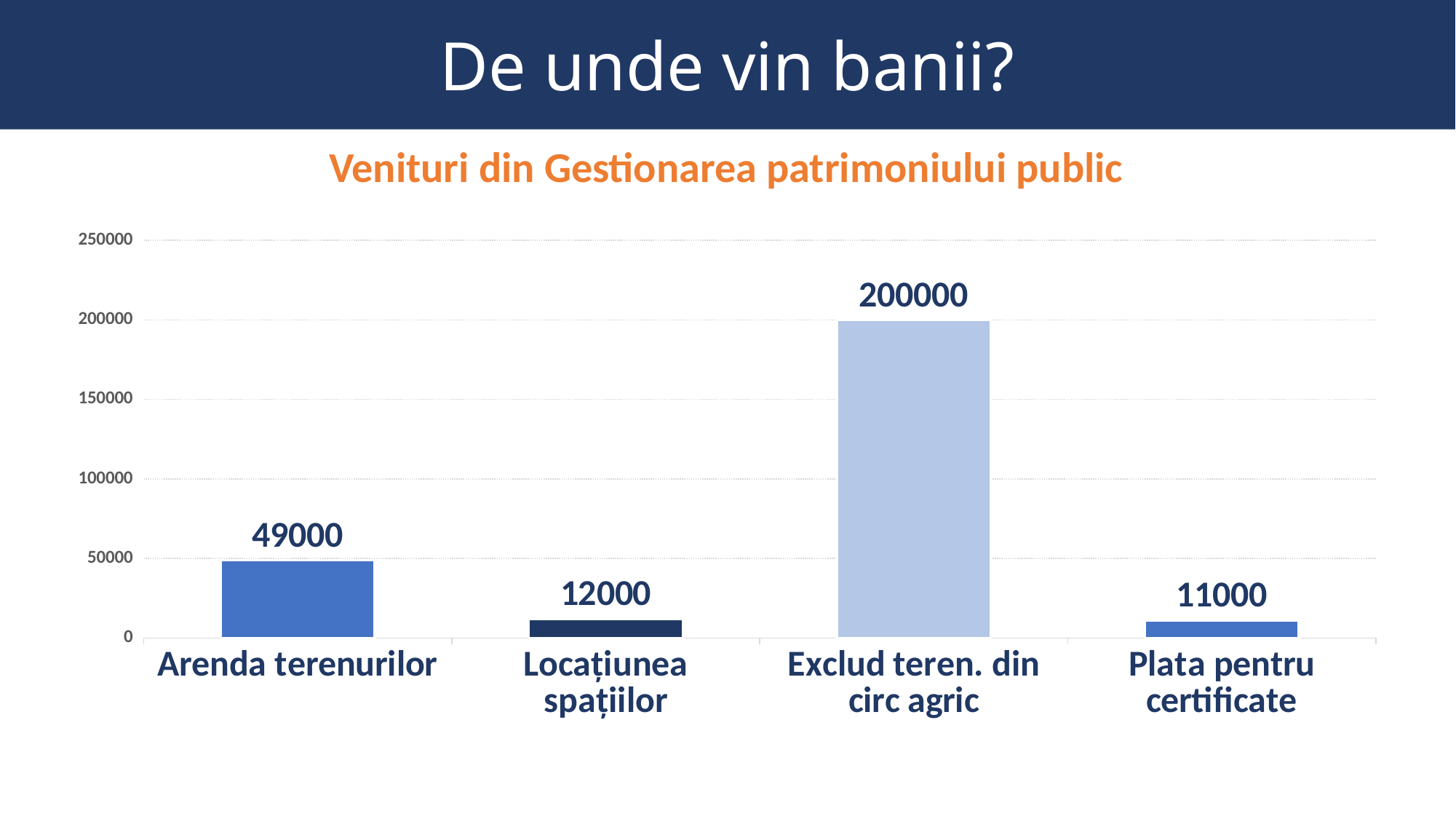
What is the title of the chart? Venituri din Gestionarea patrimoniului public Which category has the highest value? Exclud teren. din circ agric Which category has the lowest value? Plata pentru certificate Which is larger, the value for Arenda terenurilor or the value for Locațiunea spațiilor? Arenda terenurilor What is the value for Locațiunea spațiilor? 12000 What is the value for Exclud teren. din circ agric? 200000 What kind of chart is shown on the slide? Bar chart What is the difference between the values for Exclud teren. din circ agric and Arenda terenurilor? 151000 How many categories are shown in the chart? 4 What is the difference between the values for Locațiunea spațiilor and Plata pentru certificate? 1000 What is the value for Arenda terenurilor? 49000 What is the value for Plata pentru certificate? 11000